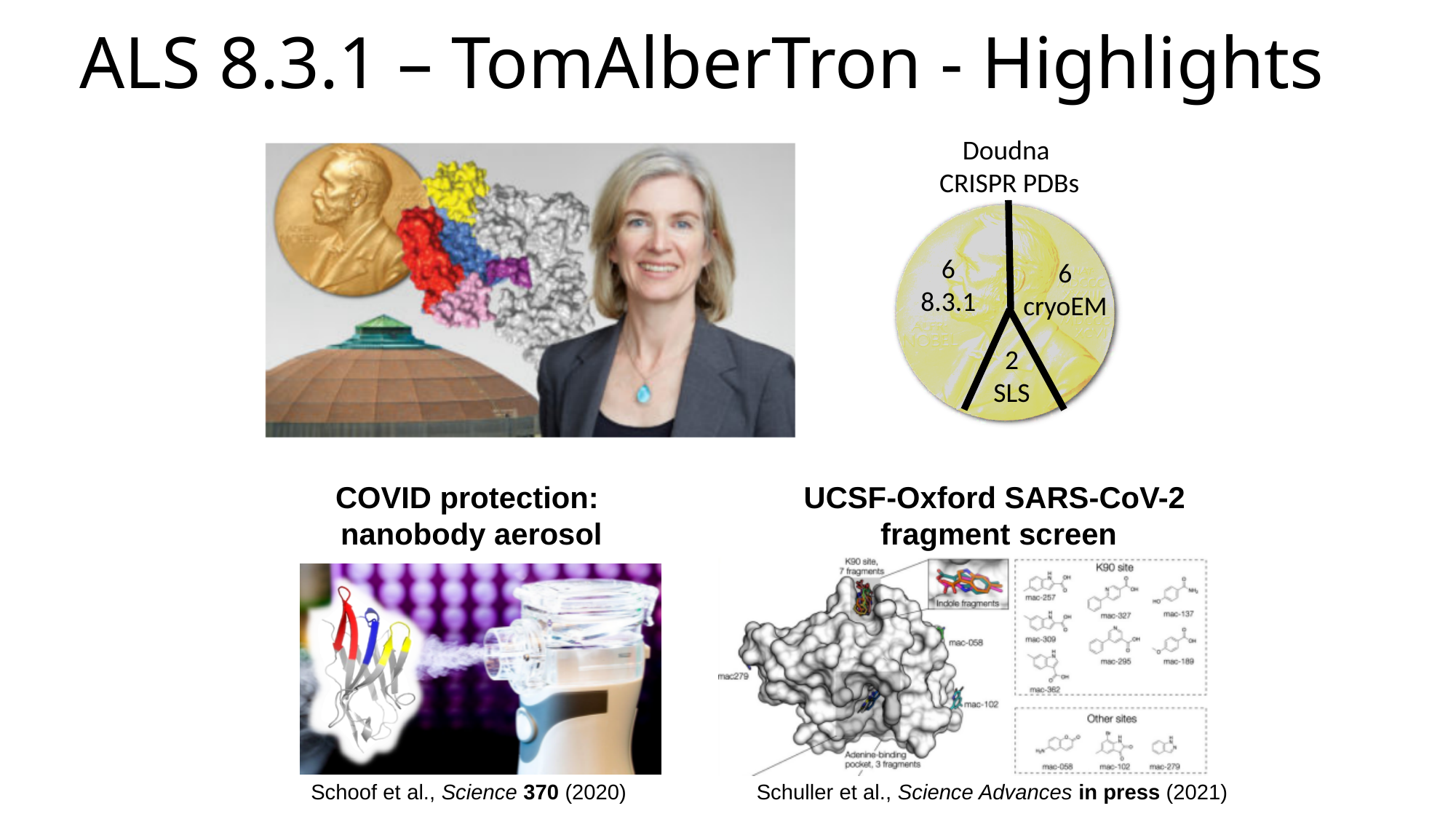
Which two slices of the Doudna CRISPR PDBs pie chart have the same value? 8.3.1 and cryoEM What kind of chart is the Doudna CRISPR PDBs chart? pie chart In the Doudna CRISPR PDBs pie chart, what is the value for SLS? 2 Which slice of the Doudna CRISPR PDBs pie chart has the smallest value? SLS In the Doudna CRISPR PDBs pie chart, what is the value for 8.3.1? 6 In the Doudna CRISPR PDBs pie chart, which is larger: SLS or cryoEM? cryoEM What is the total of all slices in the Doudna CRISPR PDBs pie chart? 14 How many slices does the Doudna CRISPR PDBs pie chart have? 3 In the Doudna CRISPR PDBs pie chart, what is the difference between the values for 8.3.1 and SLS? 4 In the Doudna CRISPR PDBs pie chart, what is the value for cryoEM? 6 What is the title of the pie chart on the slide? Doudna CRISPR PDBs In the Doudna CRISPR PDBs pie chart, which is larger: 8.3.1 or SLS? 8.3.1